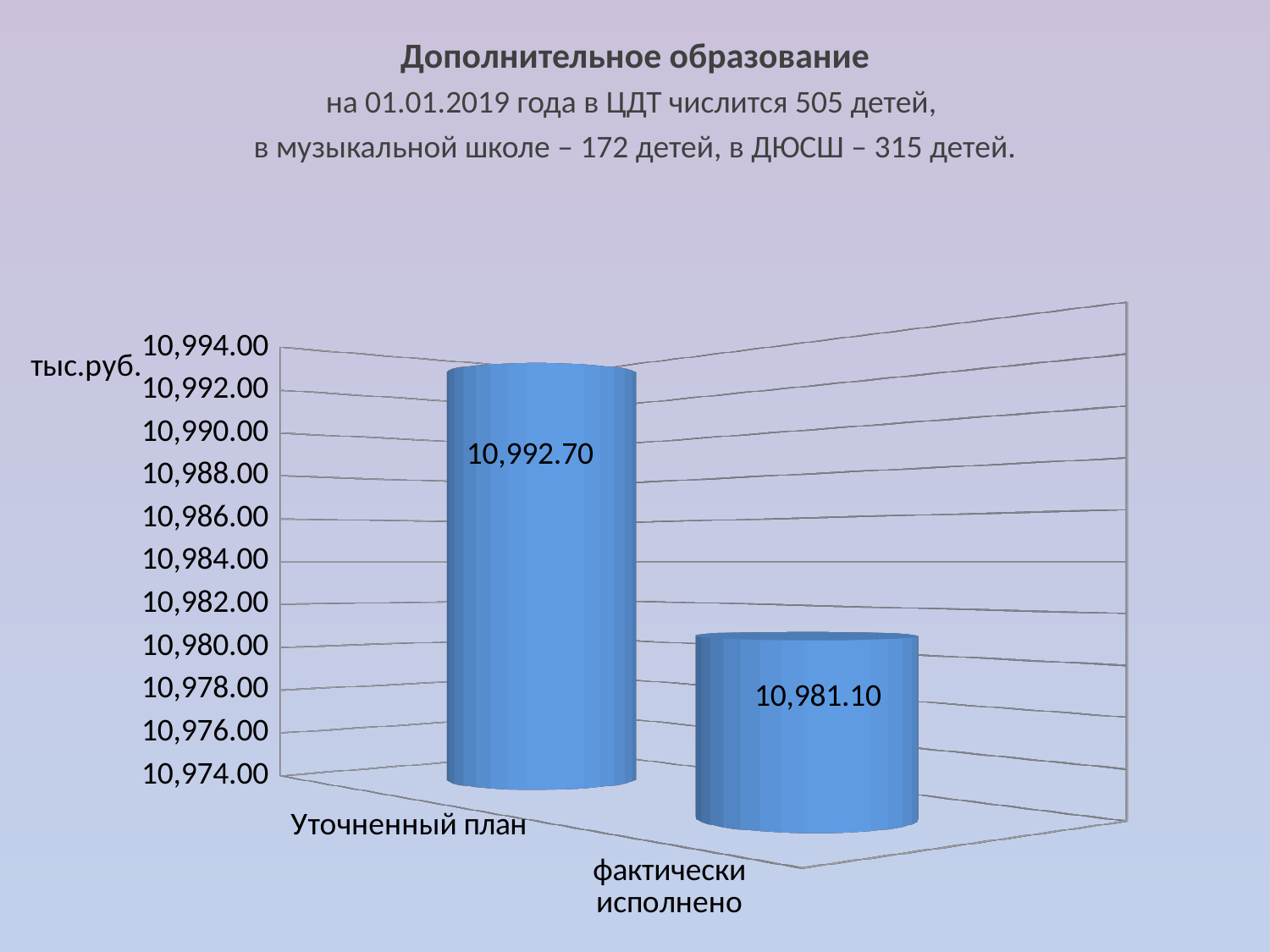
Do the values rise or fall from Уточненный план to фактически исполнено? fall What is the difference between the values for Уточненный план and фактически исполнено? 11.60 Which category has the lowest value? фактически исполнено Which is larger, the value for Уточненный план or the value for фактически исполнено? Уточненный план What kind of chart is shown on the slide? bar chart What is the value for Уточненный план? 10,992.70 What unit is shown next to the vertical axis of the chart? тыс.руб. Is the value for фактически исполнено greater or less than 10,984.00? less Is the value for Уточненный план greater or less than 10,990.00? greater What is the value for фактически исполнено? 10,981.10 Which category has the highest value? Уточненный план How many categories are shown in the chart? 2